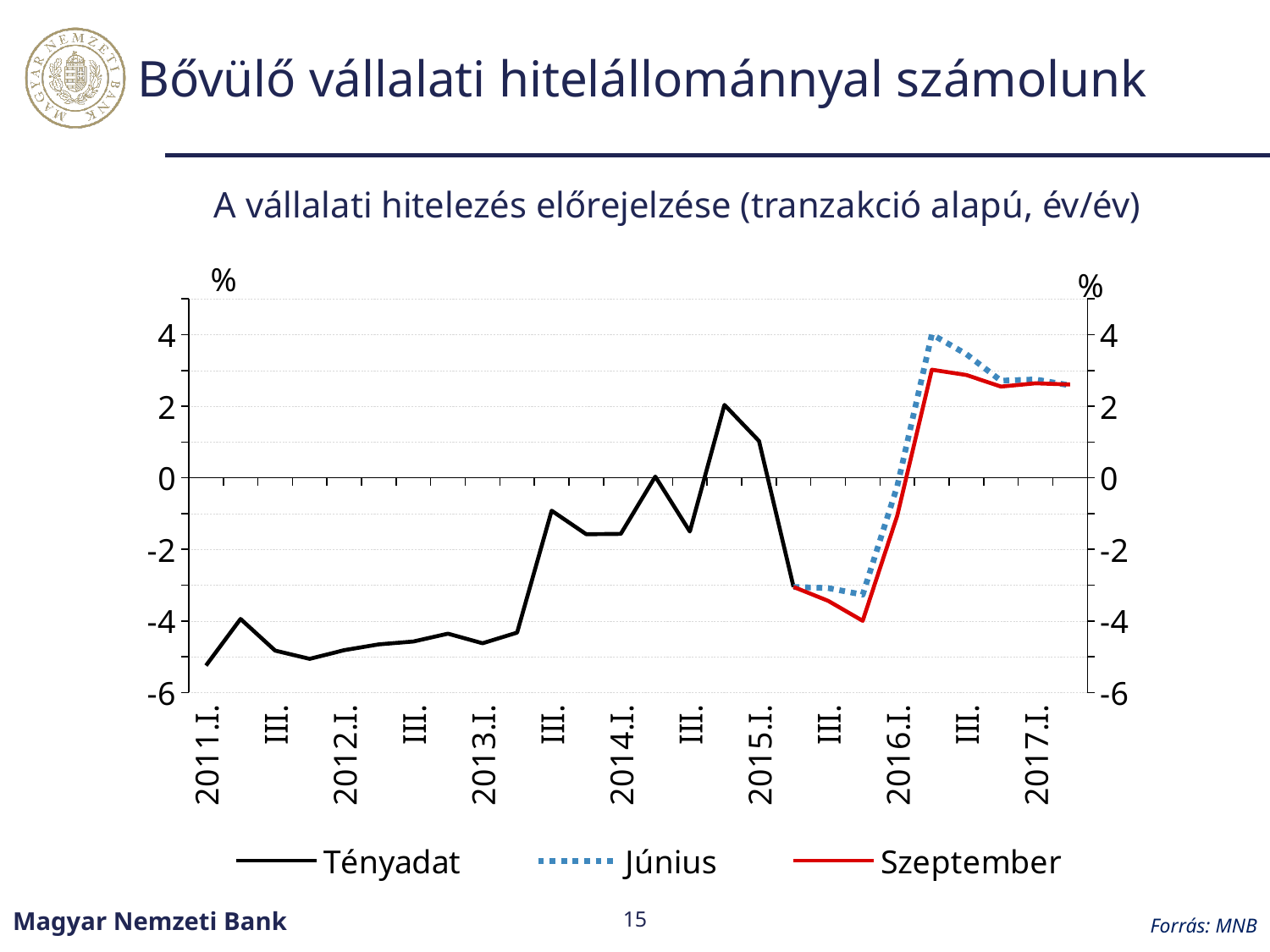
At 2016.I., which series has the higher value, Június or Szeptember? Június Is the Június value at 2015.III. greater or less than -2? less How many series does the legend list? 3 What kind of chart is shown on the slide? line chart Is the Tényadat value at 2011.I. greater or less than -4? less What is the title of the chart? A vállalati hitelezés előrejelzése (tranzakció alapú, év/év) What are the names of the series listed in the legend? Tényadat, Június, Szeptember Is the Tényadat value at 2014.III. greater or less than -2? greater At 2016.III., which series has the higher value, Június or Szeptember? Június